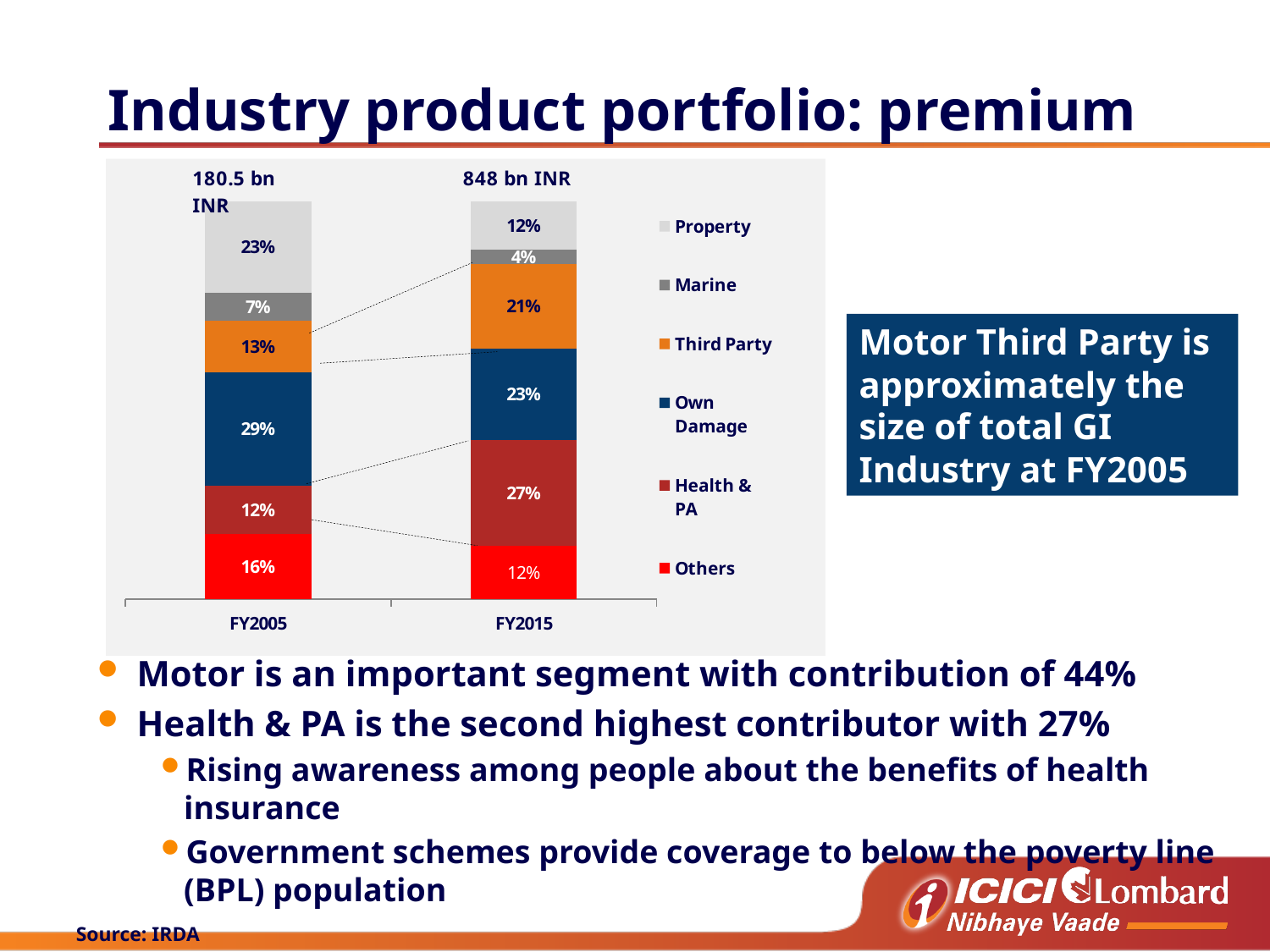
Which segment has the smallest share in FY2005? Marine By how many percentage points did the Third Party share change from FY2005 to FY2015? 8 percentage points Is the Property share larger in FY2005 or FY2015? FY2005 What kind of chart is shown on the slide? Stacked bar chart What is the Health & PA share for FY2015? 27% What total premium value is labelled above the FY2015 bar? 848 bn INR What is the Marine share for FY2015? 4% What is the Property share for FY2005? 23% Which segment has the largest share in FY2015? Health & PA What is the Own Damage share for FY2005? 29% How many series does the legend list? 6 How many categories are shown on the x axis? 2